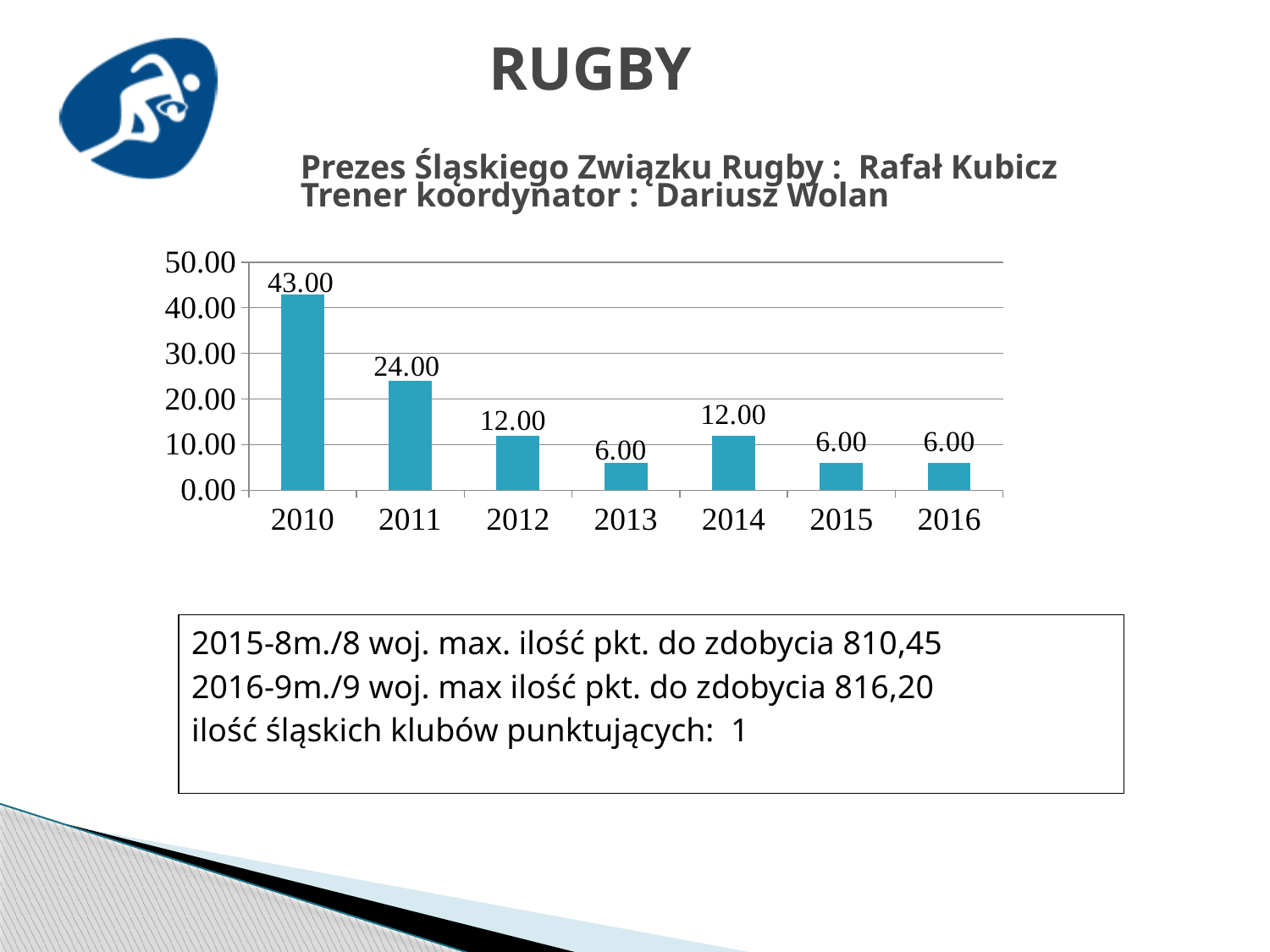
What is the value for 2014? 12.00 What is the value for 2016? 6.00 What is the difference between the values for 2010 and 2011? 19.00 What kind of chart is shown on the slide? bar chart Do the values rise or fall from 2010 to 2013? fall Which year has the highest value? 2010 What is the difference between the values for 2012 and 2013? 6.00 Which is larger, the value for 2011 or the value for 2014? 2011 Is the value for 2010 greater or less than 40.00? greater What is the value for 2010? 43.00 How many years are shown on the x axis? 7 What is the value for 2011? 24.00